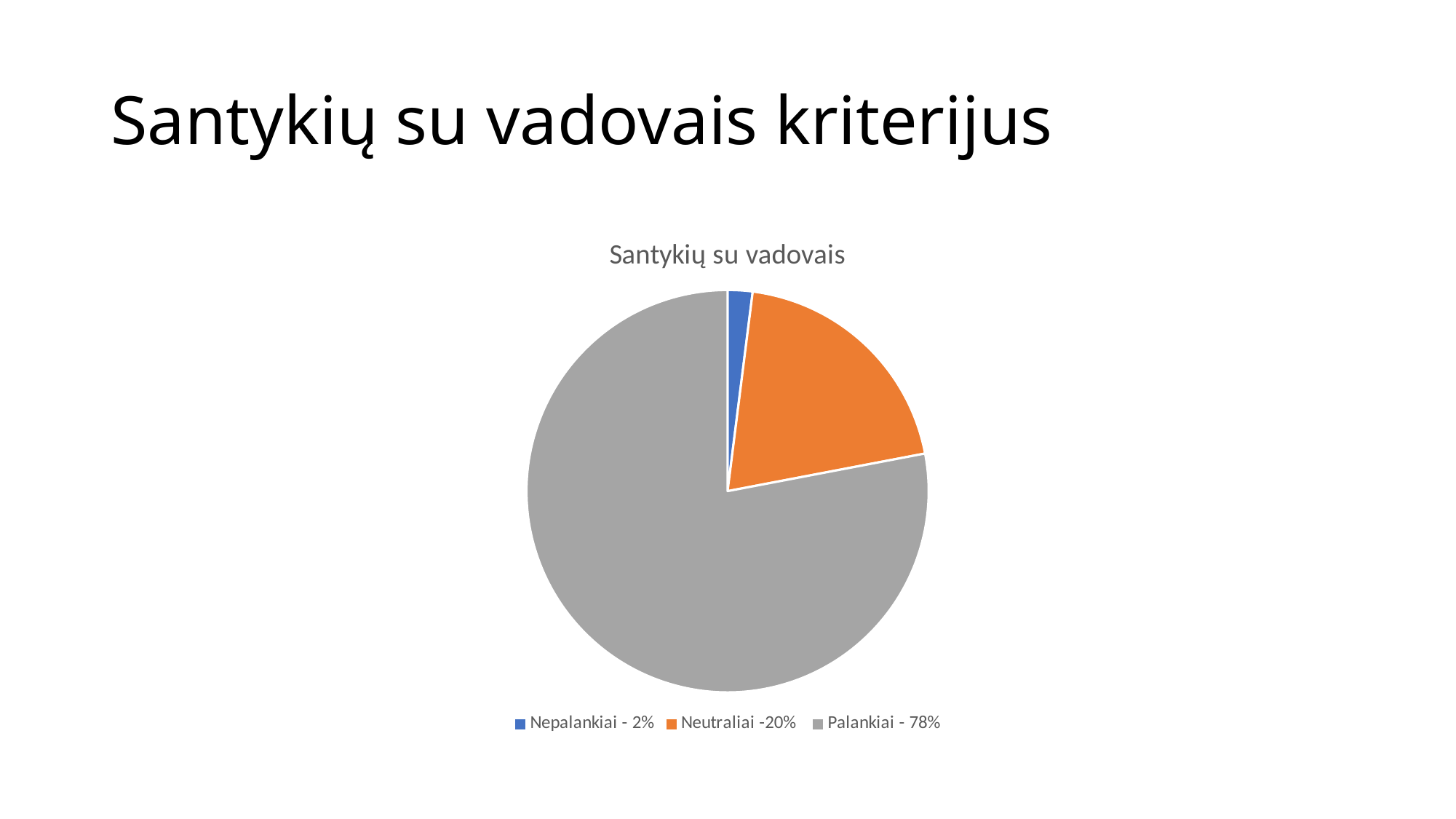
How many slices does the pie chart have? 3 Which category has the largest slice? Palankiai What is the difference between the Neutraliai and Nepalankiai shares? 18% What kind of chart is shown on the slide? pie chart What share of the pie is Neutraliai? 20% What is the title of the chart? Santykių su vadovais What share of the pie is Nepalankiai? 2% What share of the pie is Palankiai? 78% What is the difference between the Palankiai and Neutraliai shares? 58% Which category has the smallest slice? Nepalankiai What colour is the Palankiai slice? grey Which is larger, the Neutraliai slice or the Nepalankiai slice? Neutraliai